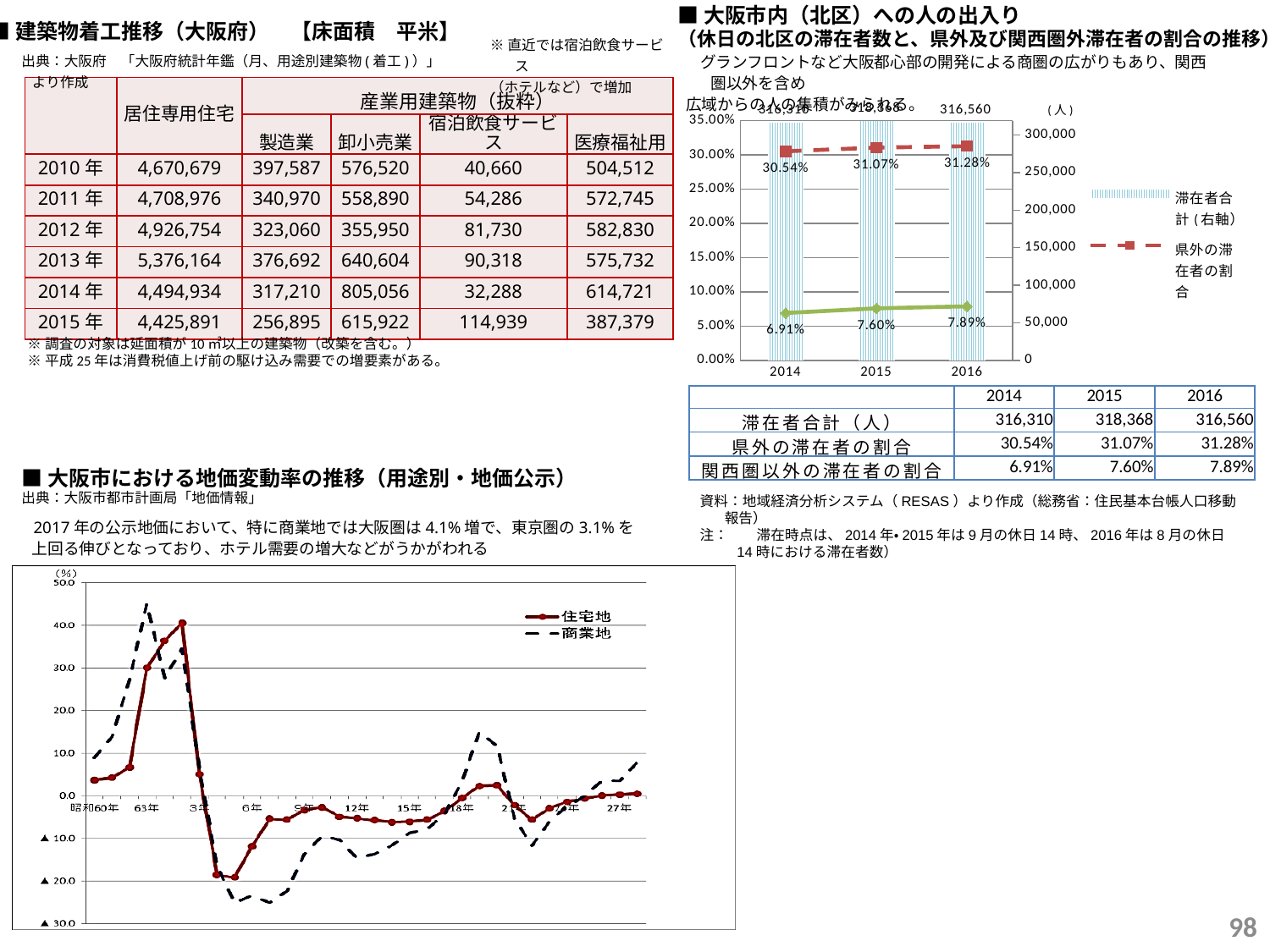
In the top-right chart on 大阪市内（北区）への人の出入り, which year has the highest 滞在者合計? 2015 In the top-right chart on 大阪市内（北区）への人の出入り, how many years are plotted on the x axis? 3 In the top-right chart on 大阪市内（北区）への人の出入り, does the 関西圏以外の滞在者の割合 rise or fall from 2014 to 2016? rise In the top-right chart on 大阪市内（北区）への人の出入り, what is the 県外の滞在者の割合 for 2016? 31.28% In the bottom-left chart on 大阪市における地価変動率の推移, is the peak value of the 住宅地 line greater or less than 30.0? greater In the bottom-left chart on 大阪市における地価変動率の推移, how many series does the legend list? 2 In the top-right chart on 大阪市内（北区）への人の出入り, what is the difference in 滞在者合計 between 2015 and 2014? 2,058 What kind of chart is the bottom-left chart on 大阪市における地価変動率の推移? line chart In the top-right chart on 大阪市内（北区）への人の出入り, how many entries does the legend list? 2 In the top-right chart on 大阪市内（北区）への人の出入り, what is the 滞在者合計 value for 2015? 318,368 In the top-right chart on 大阪市内（北区）への人の出入り, what is the 関西圏以外の滞在者の割合 for 2014? 6.91% In the top-right chart on 大阪市内（北区）への人の出入り, which year has the lowest 県外の滞在者の割合? 2014